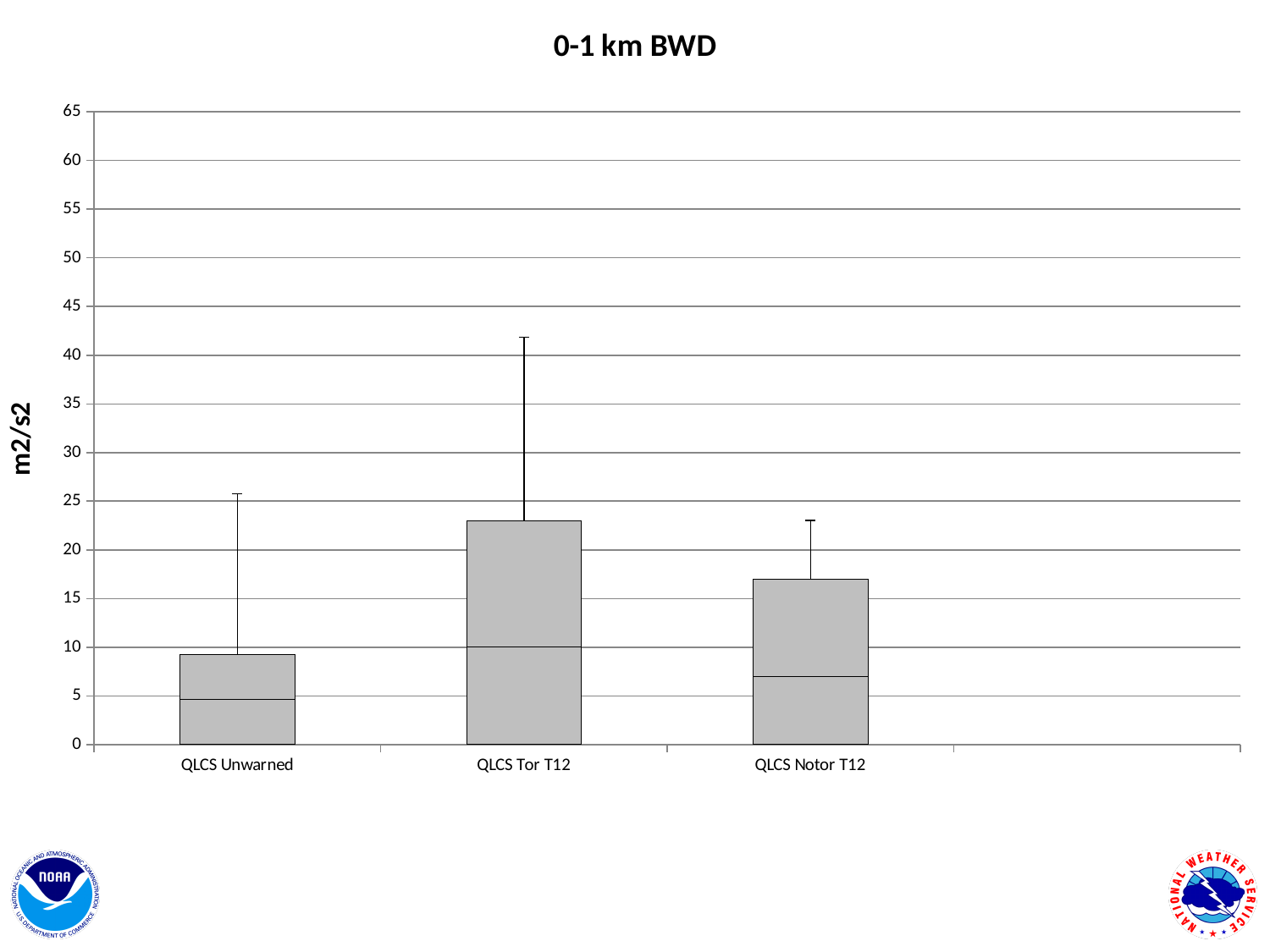
How many categories are shown on the x axis? 3 Is the top of the bar for QLCS Unwarned greater or less than 10? less Which category has the lowest bar? QLCS Unwarned What kind of chart is shown on the slide? bar chart Is the top of the bar for QLCS Tor T12 greater or less than 20? greater What is the label on the vertical axis? m2/s2 Is the top of the whisker for QLCS Tor T12 greater or less than 40? greater Which category has the highest bar? QLCS Tor T12 Which bar is taller, QLCS Notor T12 or QLCS Unwarned? QLCS Notor T12 What is the title of the chart? 0-1 km BWD